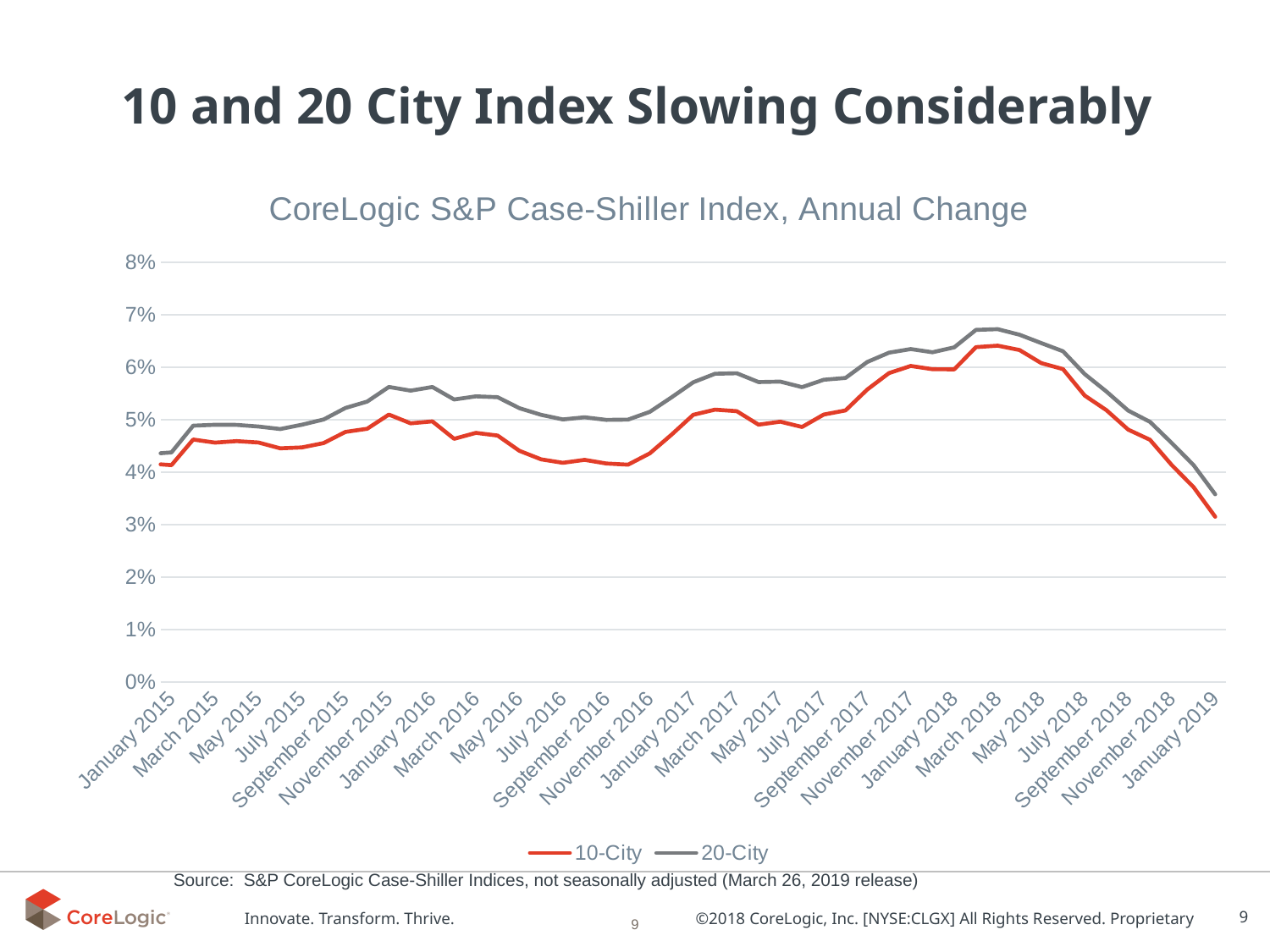
Is the value for 10-City in July 2016 greater or less than 5%? less In January 2019, which series has the higher value, 10-City or 20-City? 20-City How many series does the legend list? 2 Is the value for 20-City in March 2018 greater or less than 6%? greater Is the value for 10-City in January 2019 greater or less than 4%? less Around which month does the 20-City series reach its highest value? March 2018 What is the title of the chart? CoreLogic S&P Case-Shiller Index, Annual Change What kind of chart is shown on the slide? line chart At which month does the 10-City series reach its lowest value? January 2019 Do the values for both series rise or fall between March 2018 and January 2019? fall Which series is drawn in red? 10-City